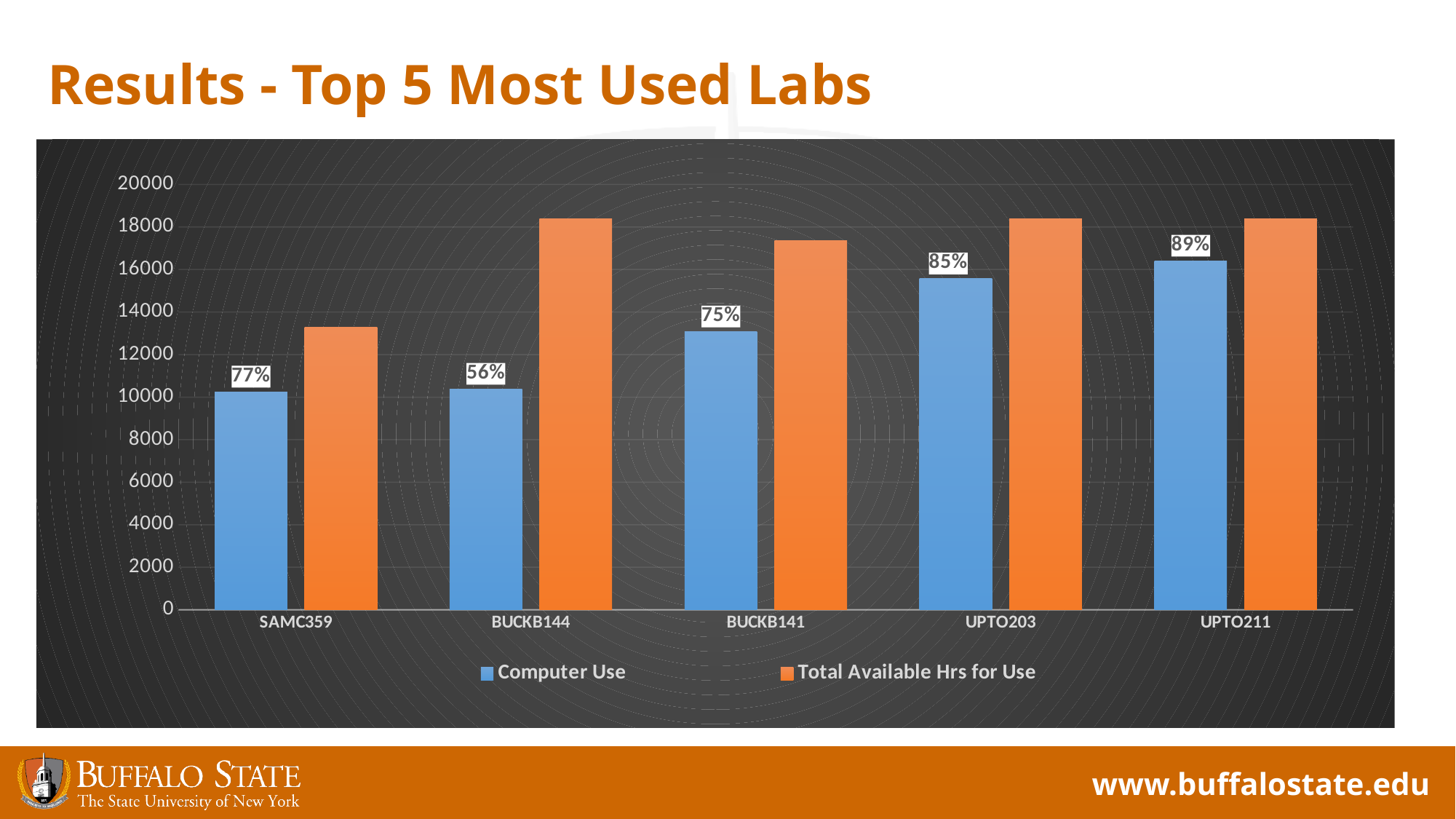
What percentage label is shown on the Computer Use bar for UPTO211? 89% What percentage label is shown on the Computer Use bar for BUCKB144? 56% Which lab has the highest Computer Use value? UPTO211 Is the Total Available Hrs for Use value for SAMC359 greater or less than 14000? less Is the Computer Use value for SAMC359 greater or less than 12000? less How many series does the chart legend list? 2 Which lab has the lowest percentage label on its Computer Use bar? BUCKB144 How many labs are shown on the x axis of the chart? 5 What percentage label is shown on the Computer Use bar for SAMC359? 77% Which is larger, the Total Available Hrs for Use for SAMC359 or for BUCKB141? BUCKB141 What is the difference in percentage points between the labels on the Computer Use bars for UPTO211 and BUCKB144? 33 What kind of chart is shown on the slide? bar chart